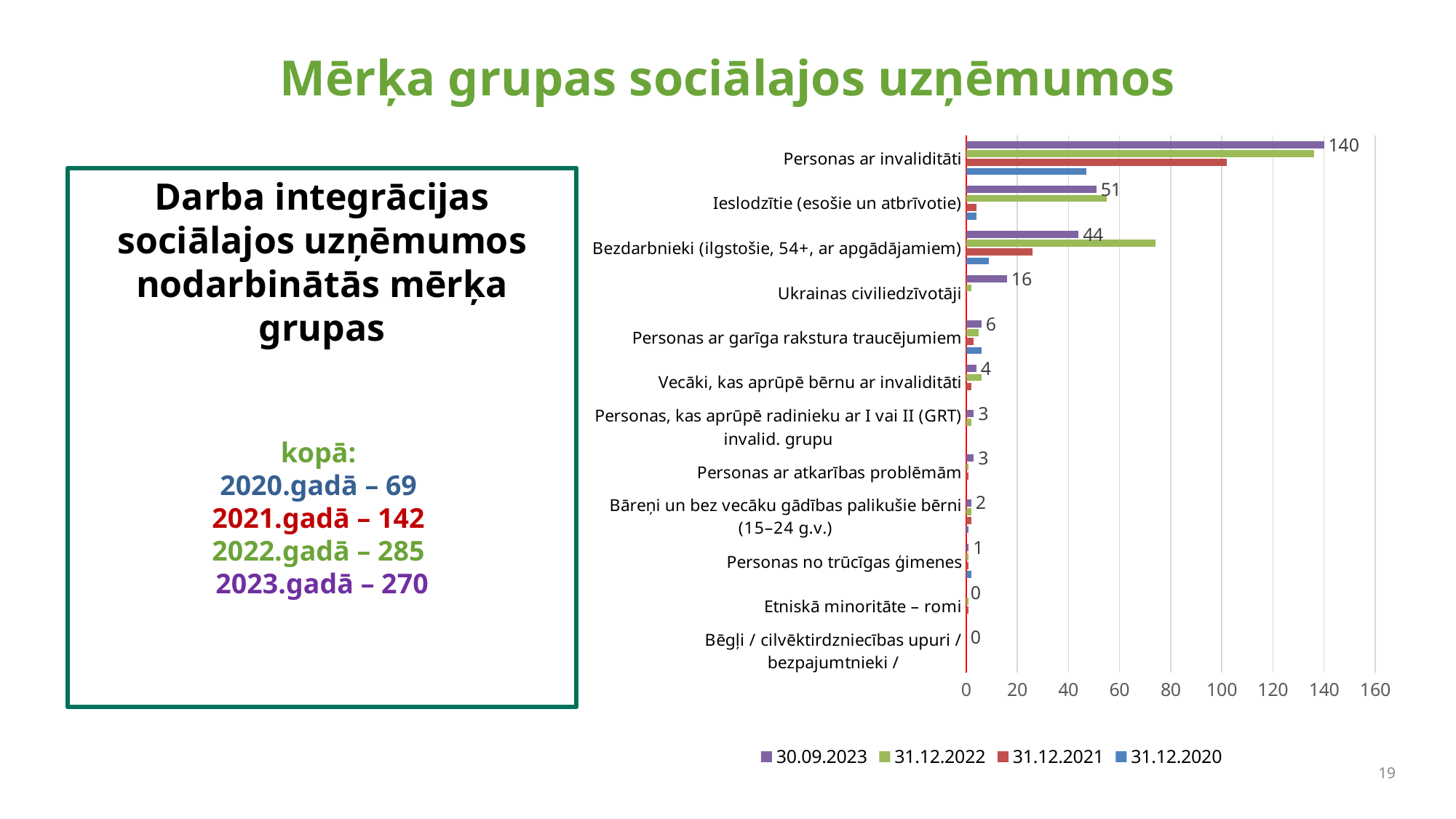
What is the 30.09.2023 value for Ieslodzītie (esošie un atbrīvotie)? 51 What is the 30.09.2023 value for Ukrainas civiliedzīvotāji? 16 For 30.09.2023, which is larger: Ieslodzītie (esošie un atbrīvotie) or Bezdarbnieki (ilgstošie, 54+, ar apgādājamiem)? Ieslodzītie (esošie un atbrīvotie) What kind of chart is shown on the slide? bar chart For Bezdarbnieki (ilgstošie, 54+, ar apgādājamiem), which series has the larger value: 31.12.2022 or 30.09.2023? 31.12.2022 How many categories are shown on the chart? 12 Which category has the highest 30.09.2023 value? Personas ar invaliditāti What is the 30.09.2023 value for Personas ar invaliditāti? 140 How many series does the legend list? 4 Is the 31.12.2022 value for Personas ar invaliditāti greater or less than 120? greater What is the difference between the 30.09.2023 values for Personas ar invaliditāti and Ieslodzītie (esošie un atbrīvotie)? 89 Is the 31.12.2020 value for Personas ar invaliditāti greater or less than 60? less